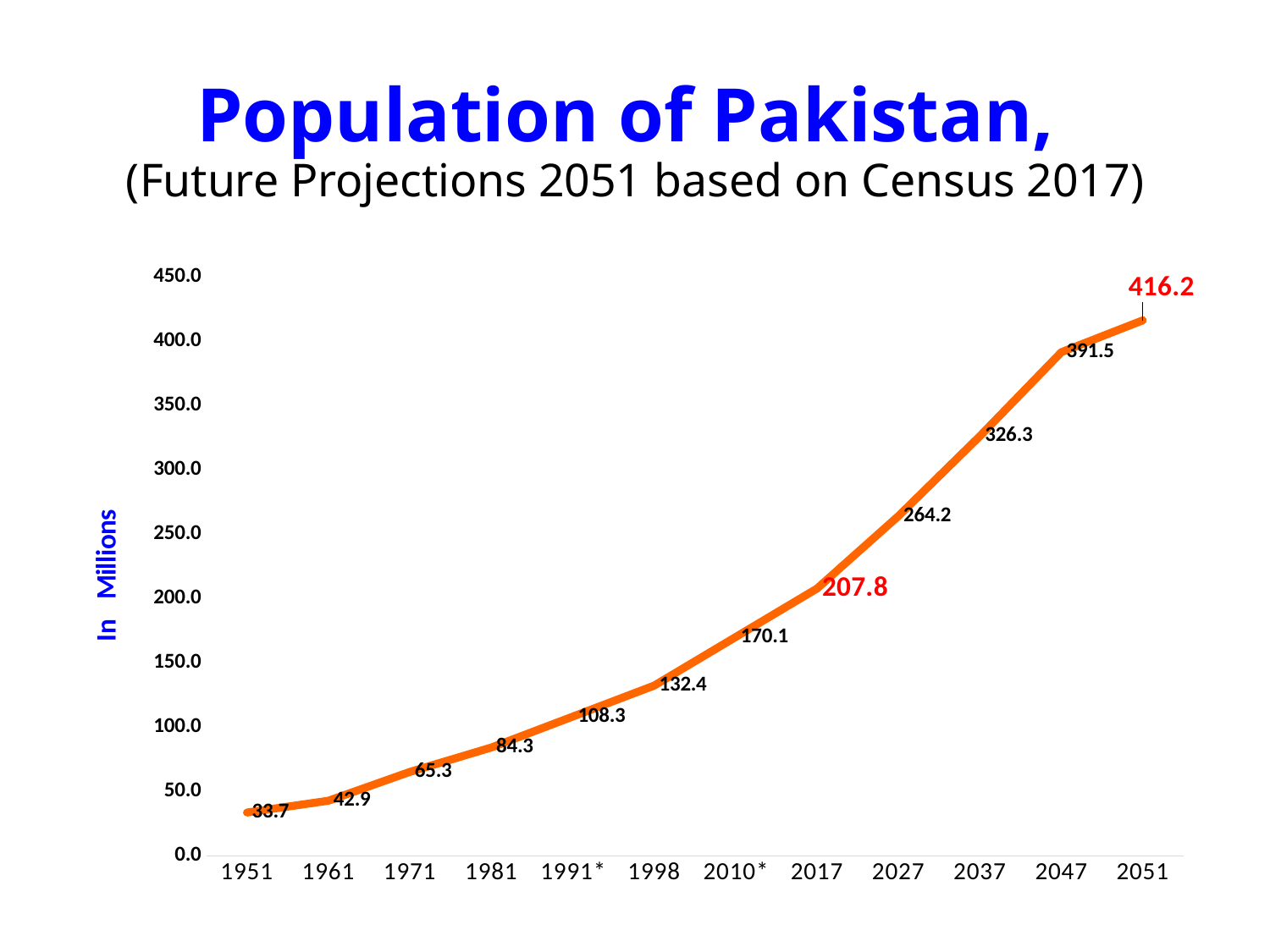
What kind of chart is shown on the slide? Line chart Do the population values rise or fall from 1951 to 2051? Rise What is the difference between the population values for 2051 and 2017? 208.4 What is the population value shown for 1951? 33.7 Which year has the highest population value on the chart? 2051 What is the projected population value shown for 2051? 416.2 What is the label on the vertical axis? In Millions Which year has the lowest population value on the chart? 1951 Which is larger, the population value for 2037 or for 2027? 2037 How many years are plotted on the x axis? 12 What is the population value shown for 1998? 132.4 What is the population value shown for 2017? 207.8